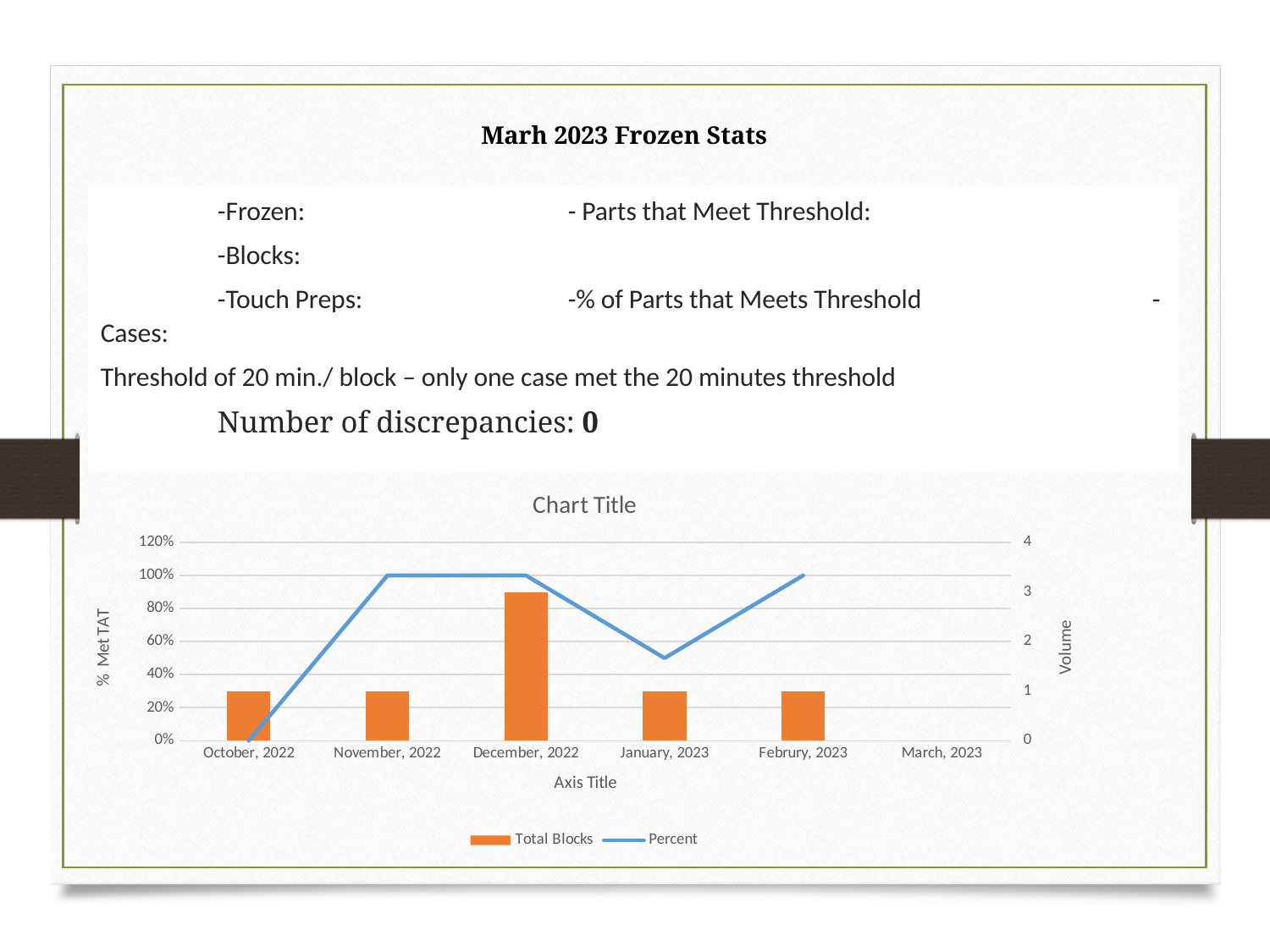
What is the Total Blocks value for December, 2022 on the Volume axis? 3 What is the Percent value for October, 2022? 0% Is the Percent value for January, 2023 greater or less than 60%? less How many month categories are shown on the x axis of the chart? 6 Which month has the tallest Total Blocks bar? December, 2022 What kind of chart is shown on the slide? A combination bar and line chart What is the Total Blocks value for October, 2022 on the Volume axis? 1 What is the Percent value for November, 2022? 100% Does the Percent line rise or fall from December, 2022 to January, 2023? fall What are the two entries listed in the chart legend? Total Blocks and Percent How many series does the chart legend list? 2 Which has the larger Total Blocks bar, December, 2022 or January, 2023? December, 2022